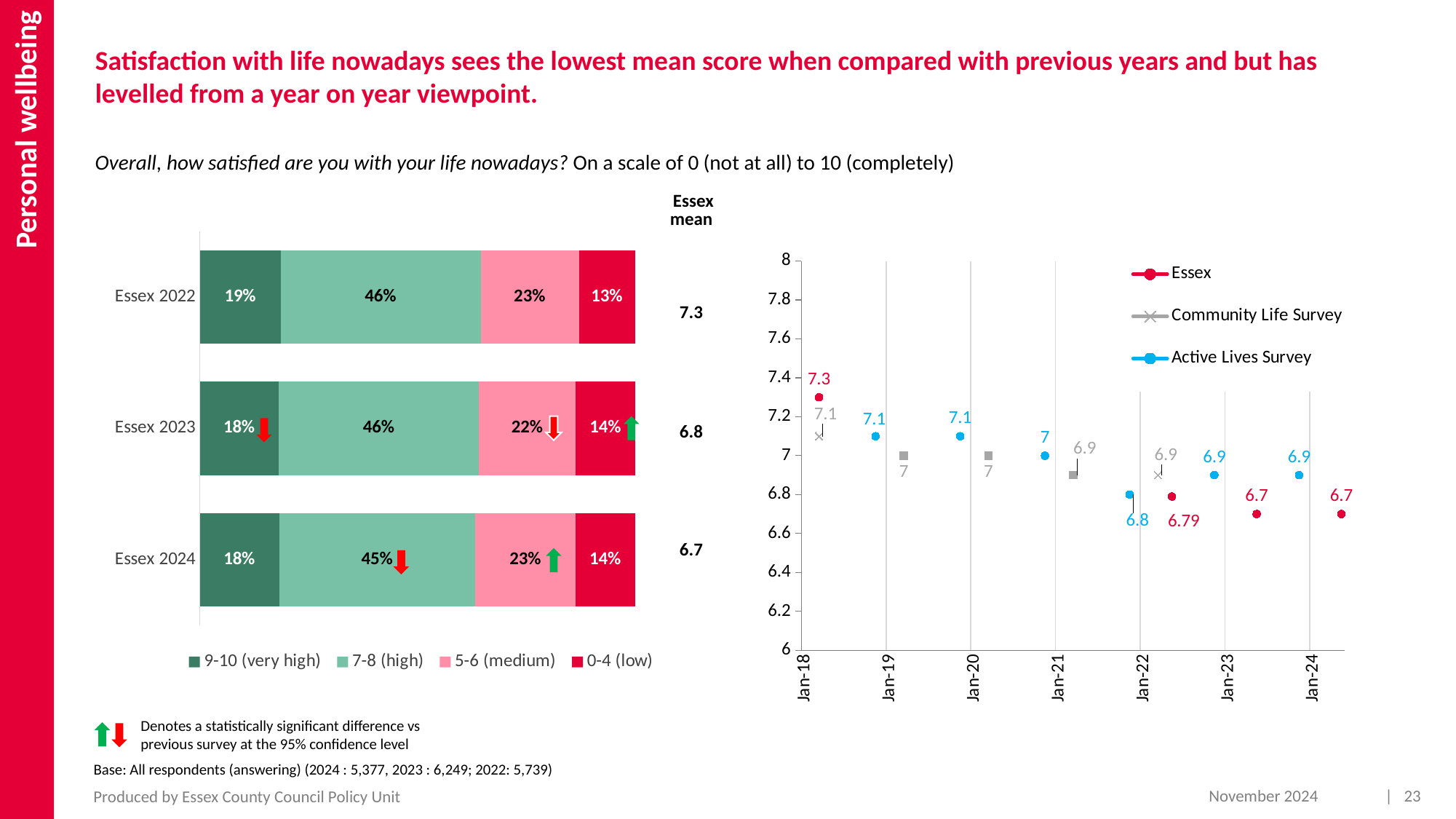
What type of chart is shown on the left of the slide? Stacked bar chart In the chart on the right, what is the Essex value plotted at Jan-18? 7.3 In the stacked bar chart on the left, which year has the highest 9-10 (very high) share? Essex 2022 In the stacked bar chart on the left, what percentage of Essex 2024 respondents gave a 7-8 (high) score? 45% In the stacked bar chart on the left, what is the difference between the 5-6 (medium) share for Essex 2022 and Essex 2023? 1% In the chart on the right, do the Essex values rise or fall from Jan-18 to Jan-24? Fall In the stacked bar chart on the left, how many series does the legend list? 4 What is the Essex mean score shown for Essex 2024? 6.7 In the chart on the right, how many series does the legend list? 3 In the stacked bar chart on the left, what is the 0-4 (low) share for Essex 2023? 14% In the stacked bar chart on the left, what percentage of Essex 2022 respondents gave a 9-10 (very high) score? 19% In the chart on the right, what is the Active Lives Survey value plotted at Jan-22? 6.8